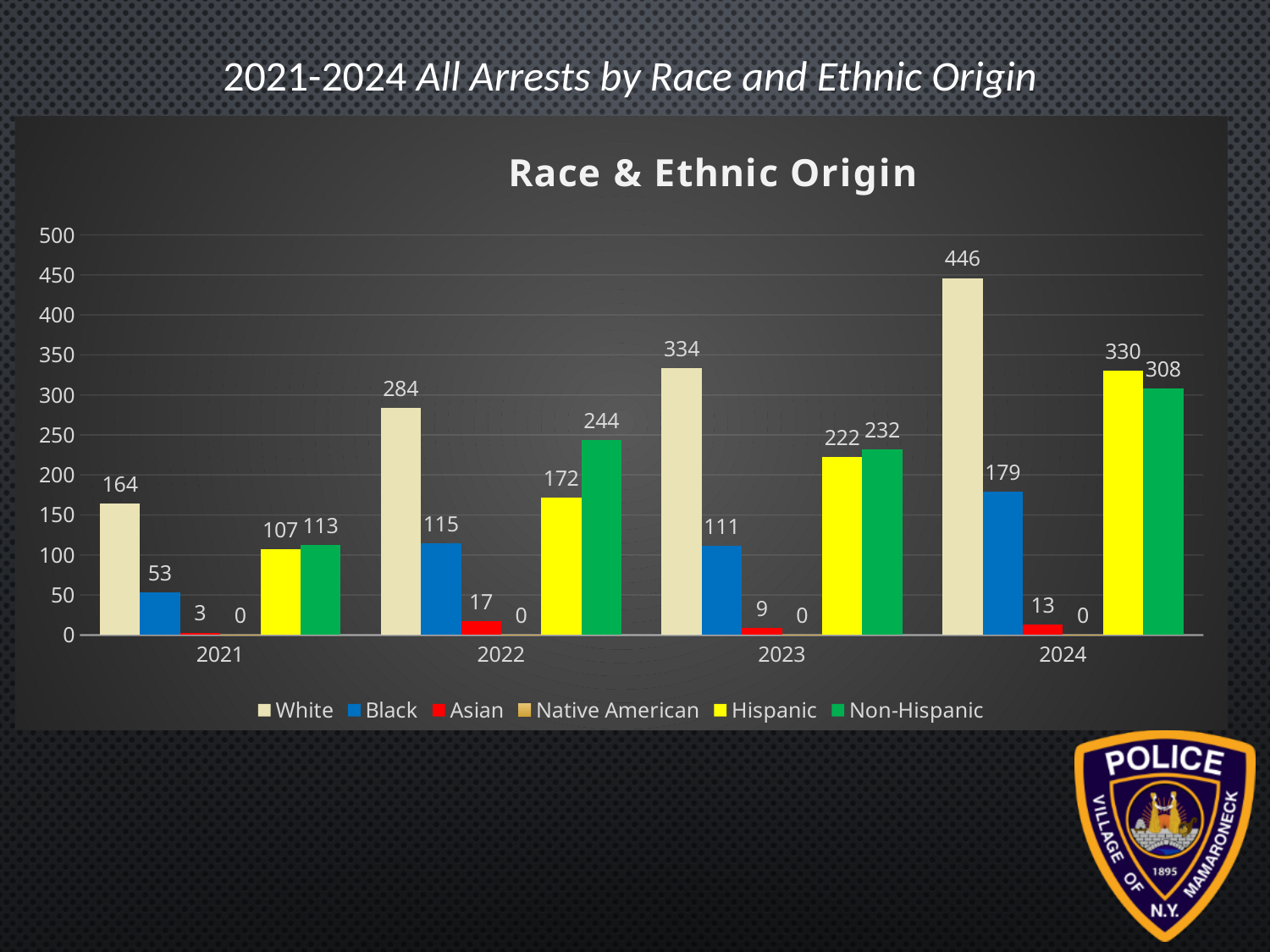
Is the value for White in 2023 greater or less than 300? greater What is the value for Asian in 2023? 9 How many series does the legend list? 6 What is the value for Hispanic in 2022? 172 How many years are shown on the x axis? 4 In which year is the White value highest? 2024 Does the White value rise or fall from 2021 to 2024? Rise What kind of chart is shown? Bar chart What is the value for White in 2024? 446 Which is larger in 2022, Hispanic or Non-Hispanic? Non-Hispanic In which year is the Black value lowest? 2021 What is the difference between the Hispanic and Non-Hispanic values in 2024? 22